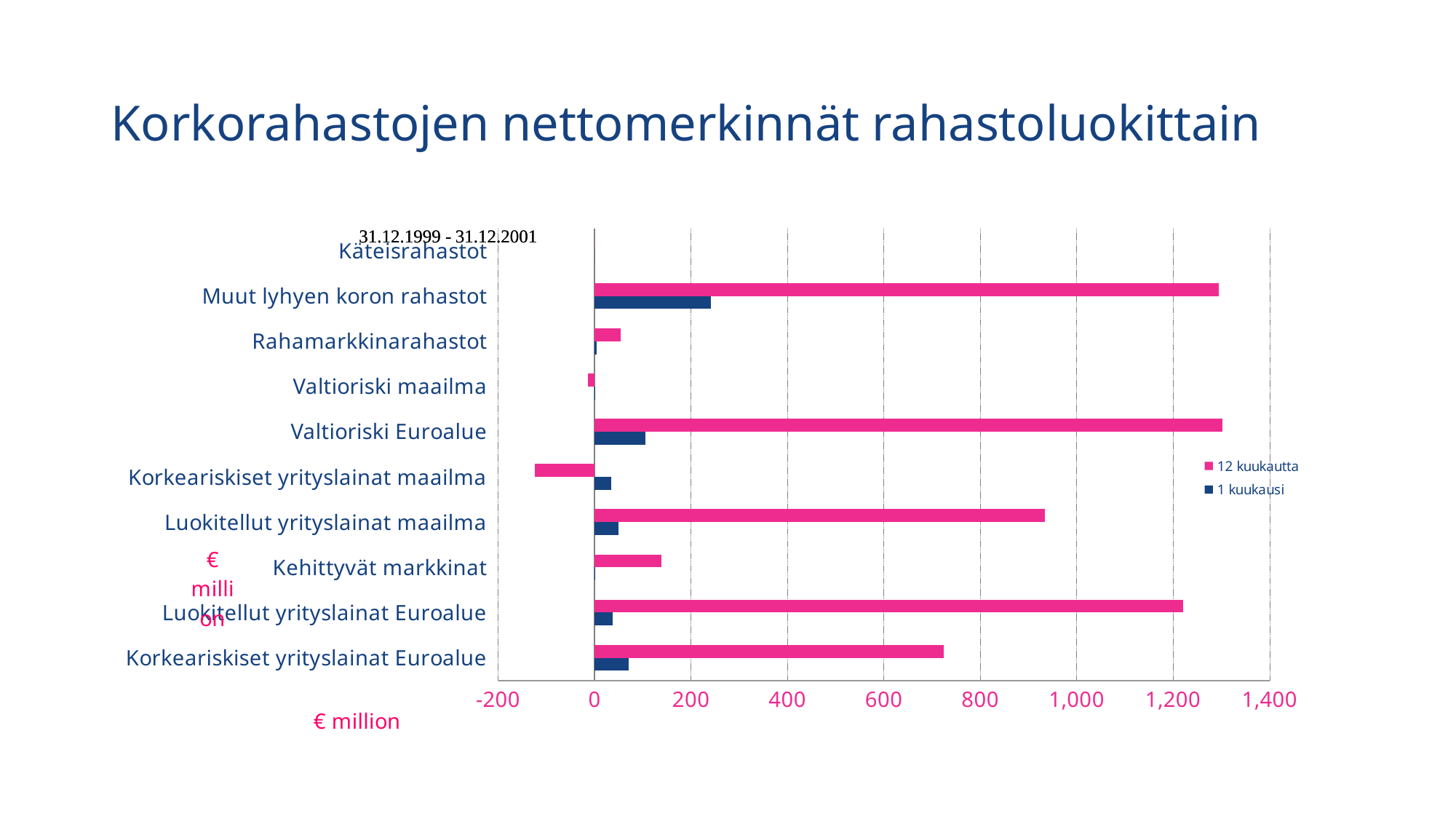
Is the 1 kuukausi value for Muut lyhyen koron rahastot greater or less than 200? greater Which colour represents the 12 kuukautta series? pink For the 12 kuukautta series, which is larger: Luokitellut yrityslainat maailma or Korkeariskiset yrityslainat Euroalue? Luokitellut yrityslainat maailma What kind of chart is shown on the slide? bar chart What is the title of the chart on the slide? Korkorahastojen nettomerkinnät rahastoluokittain Is the 12 kuukautta value for Muut lyhyen koron rahastot greater or less than 1,200? greater How many series does the legend list? 2 Is the 12 kuukautta value for Korkeariskiset yrityslainat Euroalue greater or less than 800? less How many fund categories are listed on the vertical axis? 10 Which category has the highest value for the 1 kuukausi series? Muut lyhyen koron rahastot Which category has the lowest value for the 12 kuukautta series? Korkeariskiset yrityslainat maailma